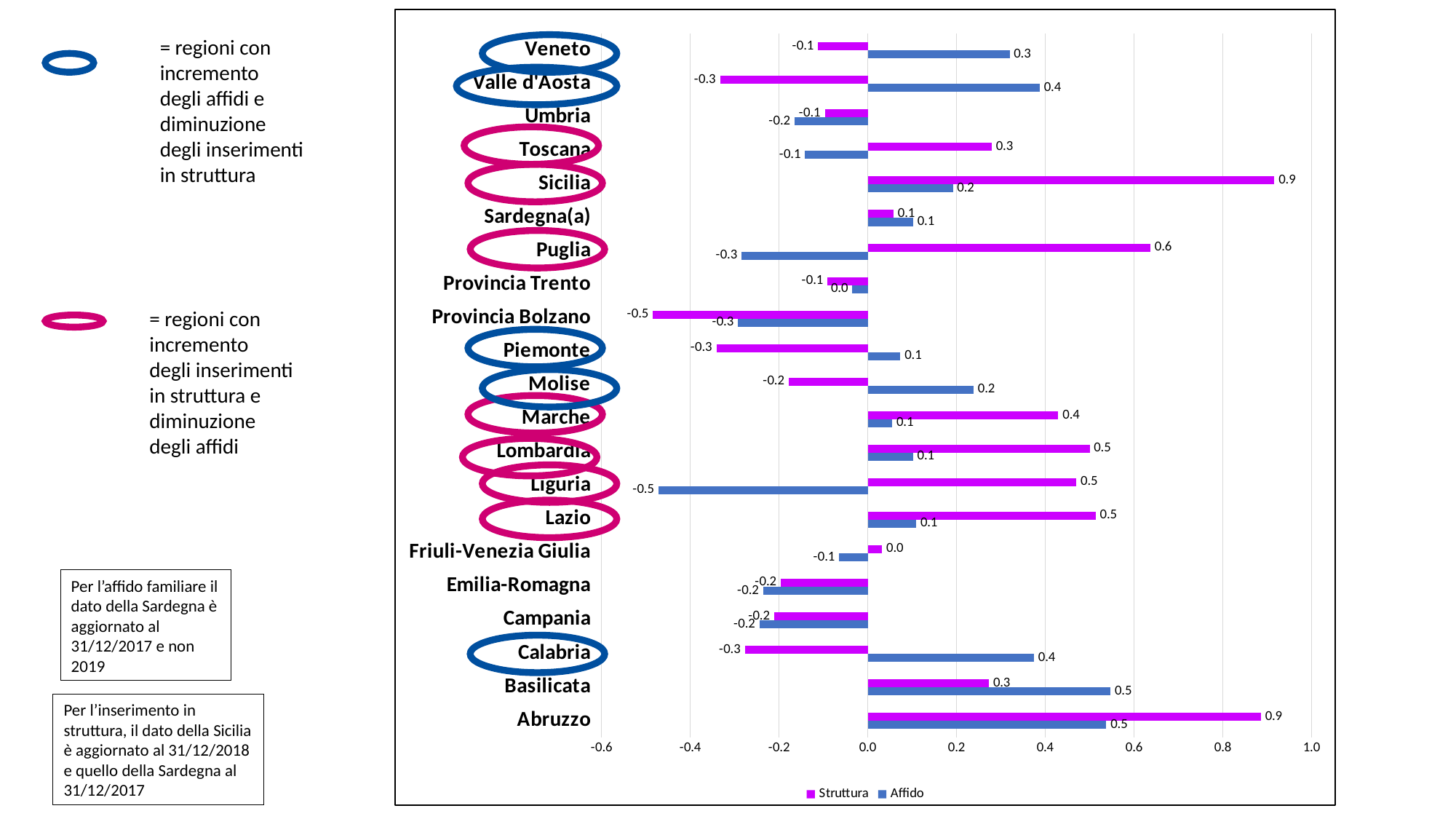
Which is larger for Calabria, the Struttura value or the Affido value? Affido How many series does the chart legend list? 2 Which region has the lowest Struttura value? Provincia Bolzano How many regions (categories) are plotted on the chart? 21 What is the Struttura value for Provincia Bolzano? -0.5 What is the Affido value for Valle d'Aosta? 0.4 Which region has the lowest Affido value? Liguria What is the Affido value for Liguria? -0.5 What is the Struttura value for Sicilia? 0.9 Which series is shown in magenta in the legend? Struttura What is the difference between the Struttura value and the Affido value for Puglia? 0.9 What kind of chart is shown on the slide? bar chart